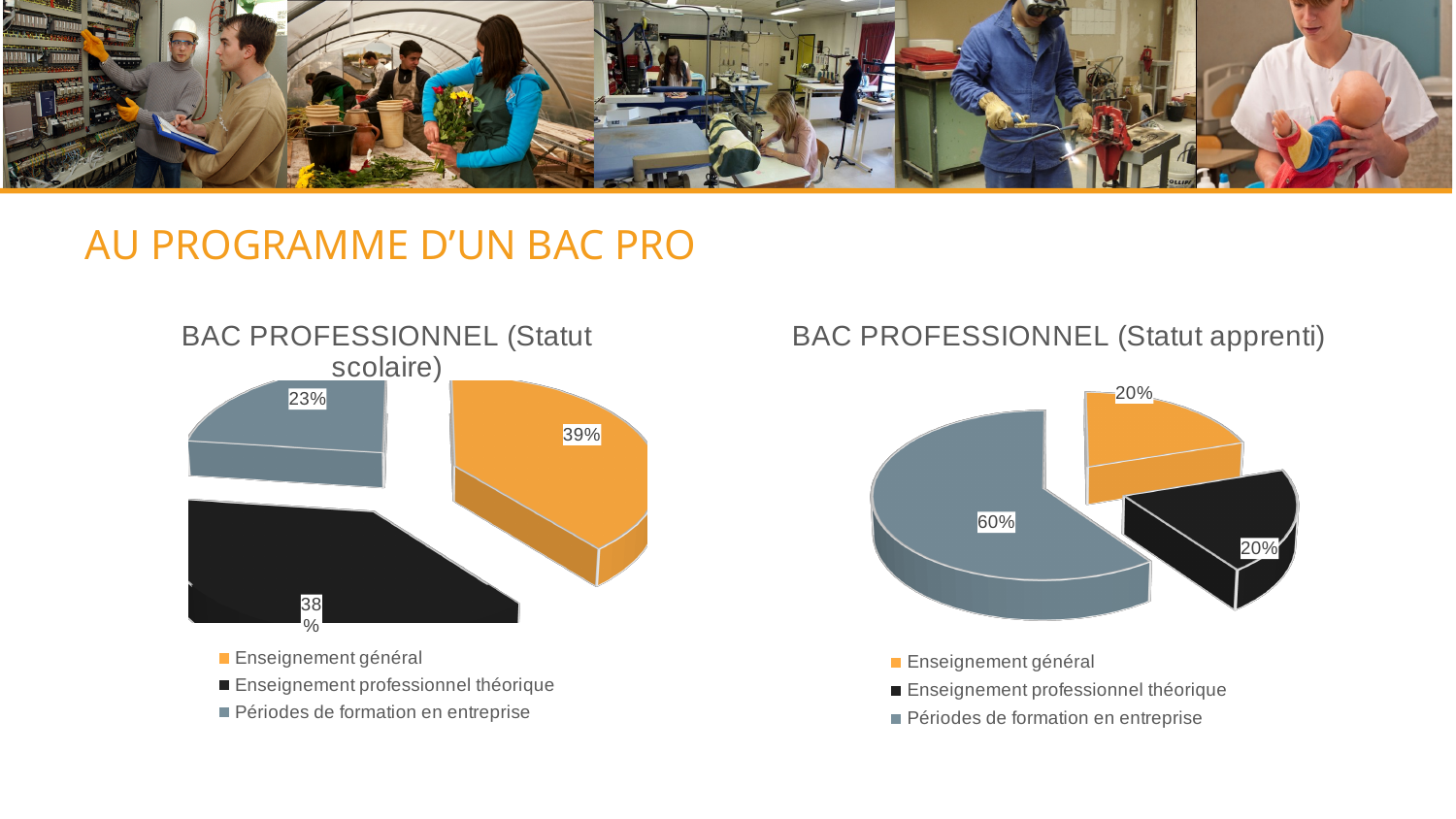
How many categories does the BAC PROFESSIONNEL (Statut scolaire) chart show? 3 In the BAC PROFESSIONNEL (Statut apprenti) chart, what is the difference between Périodes de formation en entreprise and Enseignement général? 40% In the BAC PROFESSIONNEL (Statut scolaire) chart, what share is Enseignement professionnel théorique? 38% In the BAC PROFESSIONNEL (Statut apprenti) chart, what share is Enseignement général? 20% Which category is shown in orange in the BAC PROFESSIONNEL (Statut apprenti) chart? Enseignement général In the BAC PROFESSIONNEL (Statut scolaire) chart, which category has the smallest slice? Périodes de formation en entreprise What type of chart is the BAC PROFESSIONNEL (Statut apprenti) chart? Pie chart In the BAC PROFESSIONNEL (Statut apprenti) chart, what share is Périodes de formation en entreprise? 60% In the BAC PROFESSIONNEL (Statut scolaire) chart, what is the difference between Enseignement général and Périodes de formation en entreprise? 16% In the BAC PROFESSIONNEL (Statut scolaire) chart, what share is Enseignement général? 39% In the BAC PROFESSIONNEL (Statut apprenti) chart, which category has the largest slice? Périodes de formation en entreprise In the BAC PROFESSIONNEL (Statut scolaire) chart, what share is Périodes de formation en entreprise? 23%